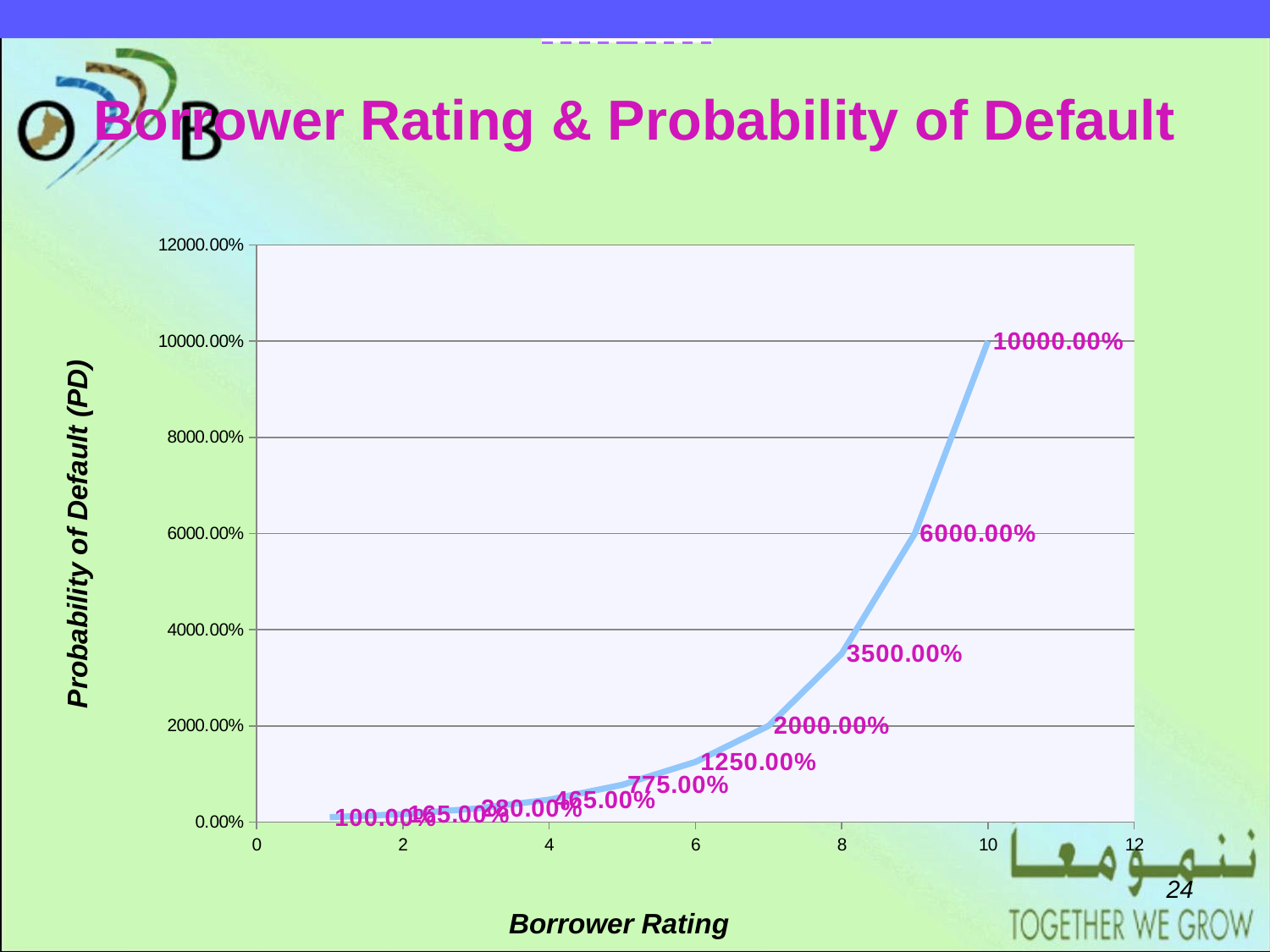
What is the difference in probability of default between borrower rating 8 and borrower rating 7? 1500.00% Which borrower rating has the lowest probability of default? 1 What is the probability of default for a borrower rating of 10? 10000.00% What is the probability of default for a borrower rating of 7? 2000.00% What kind of chart is shown on the slide? line chart Which borrower rating has the highest probability of default? 10 What is the probability of default for a borrower rating of 8? 3500.00% What is the difference in probability of default between borrower rating 10 and borrower rating 9? 4000.00% Does the probability of default rise or fall as the borrower rating increases? rise What is the probability of default for a borrower rating of 9? 6000.00% What is the probability of default for a borrower rating of 6? 1250.00% What is the title of the vertical axis? Probability of Default (PD)